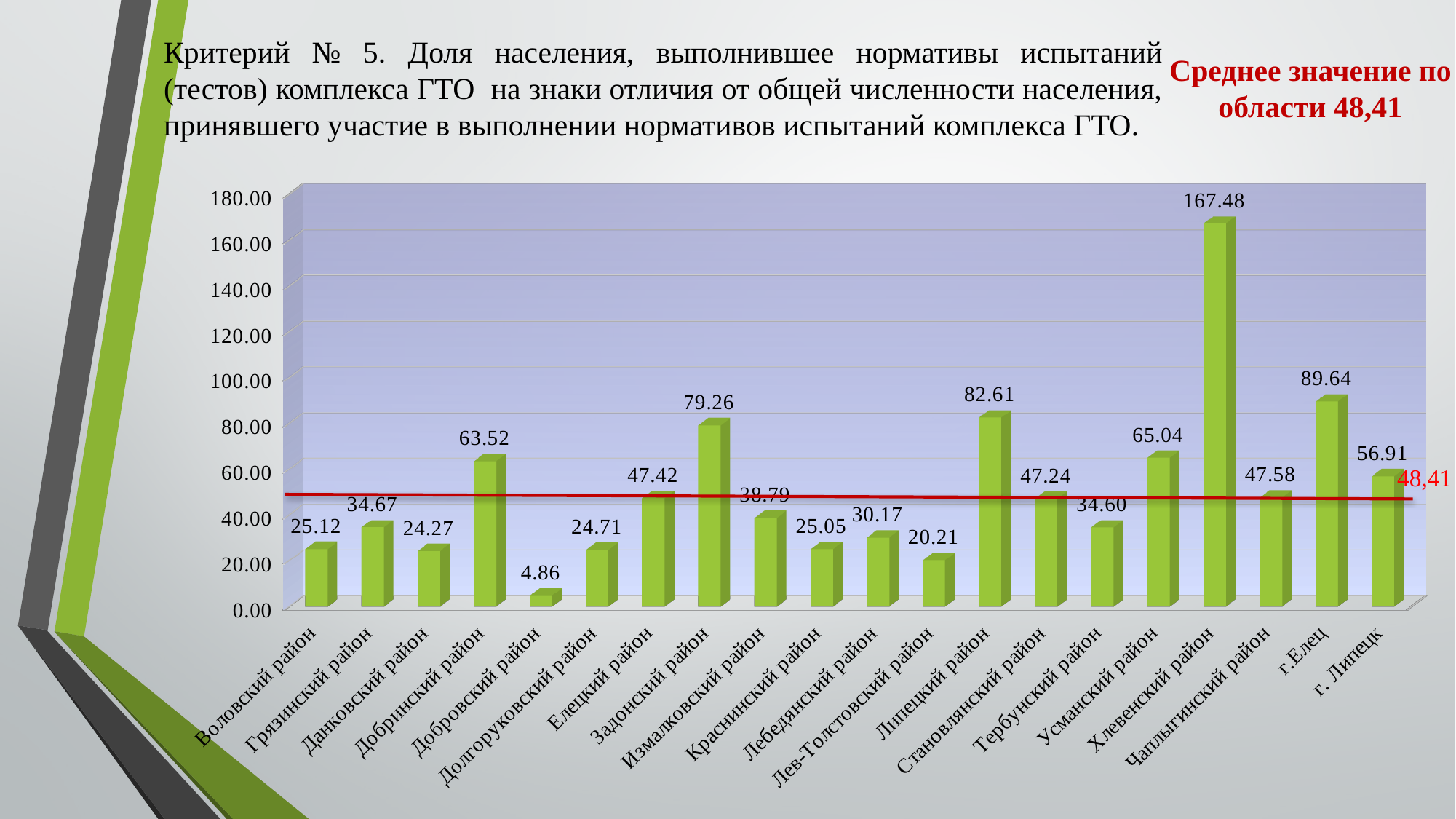
What value does the red horizontal line on the chart mark? 48,41 How many districts are shown on the chart? 20 Which is larger, the value for Усманский район or Добринский район? Усманский район What is the value for г. Липецк? 56.91 What is the difference between the values for Липецкий район and Задонский район? 3.35 Is the value for Хлевенский район greater or less than 160? greater What is the value for Добровский район? 4.86 What is the difference between the values for Хлевенский район and г.Елец? 77.84 Which district has the highest value? Хлевенский район Which district has the lowest value? Добровский район What is the value for Хлевенский район? 167.48 What kind of chart is shown on the slide? bar chart